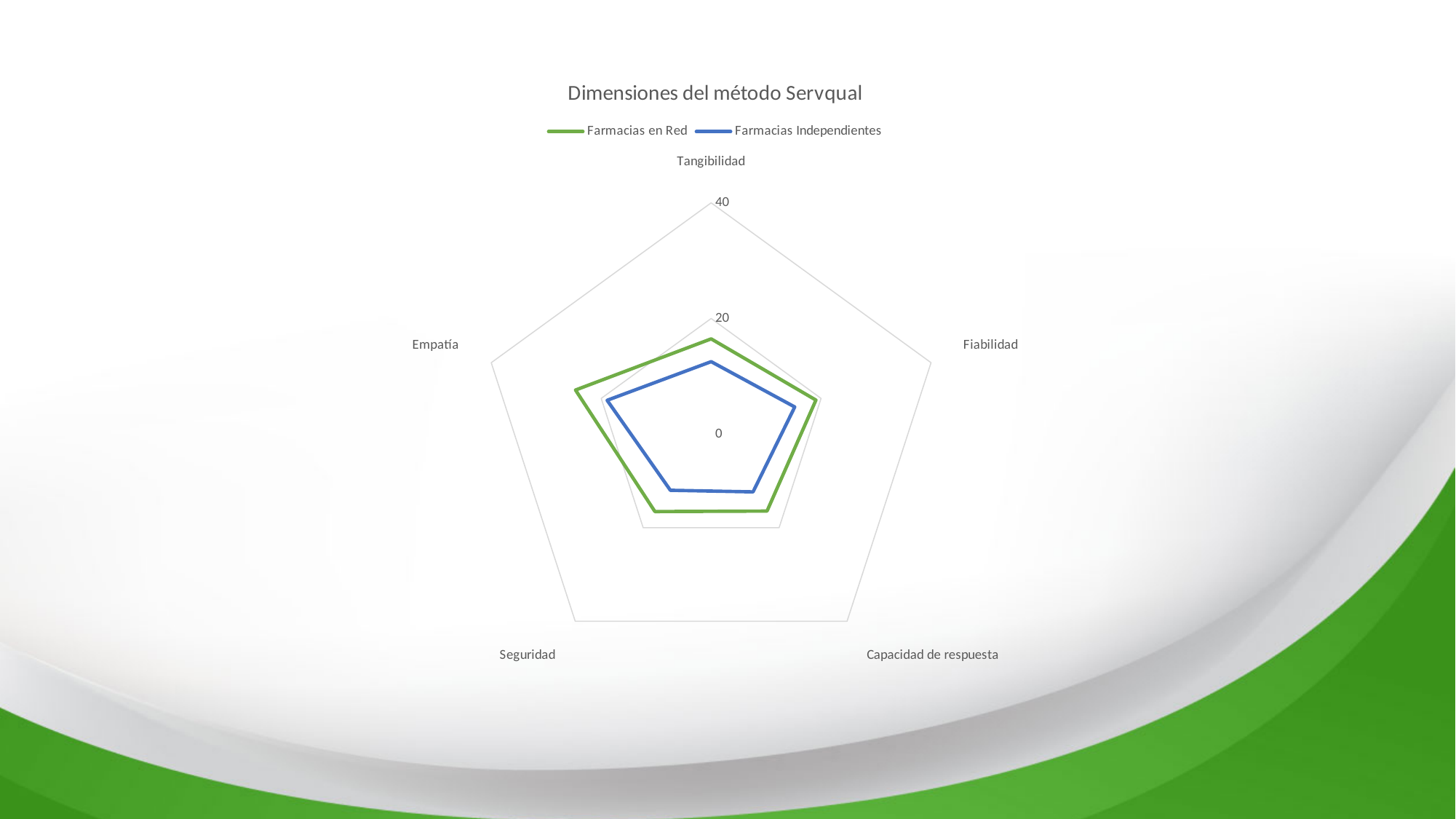
Is the value for Farmacias Independientes at Capacidad de respuesta greater or less than 20? less For Seguridad, which series has the larger value, Farmacias en Red or Farmacias Independientes? Farmacias en Red How many series does the legend list? 2 For Tangibilidad, which series has the larger value, Farmacias en Red or Farmacias Independientes? Farmacias en Red Is the value for Farmacias Independientes at Tangibilidad greater or less than 20? less Is the value for Farmacias Independientes at Fiabilidad greater or less than 20? less How many dimensions (categories) are plotted on the radar chart? 5 What kind of chart is shown on the slide? Radar chart What is the title of the chart? Dimensiones del método Servqual For Empatía, which series has the larger value, Farmacias en Red or Farmacias Independientes? Farmacias en Red Which series is drawn in green? Farmacias en Red